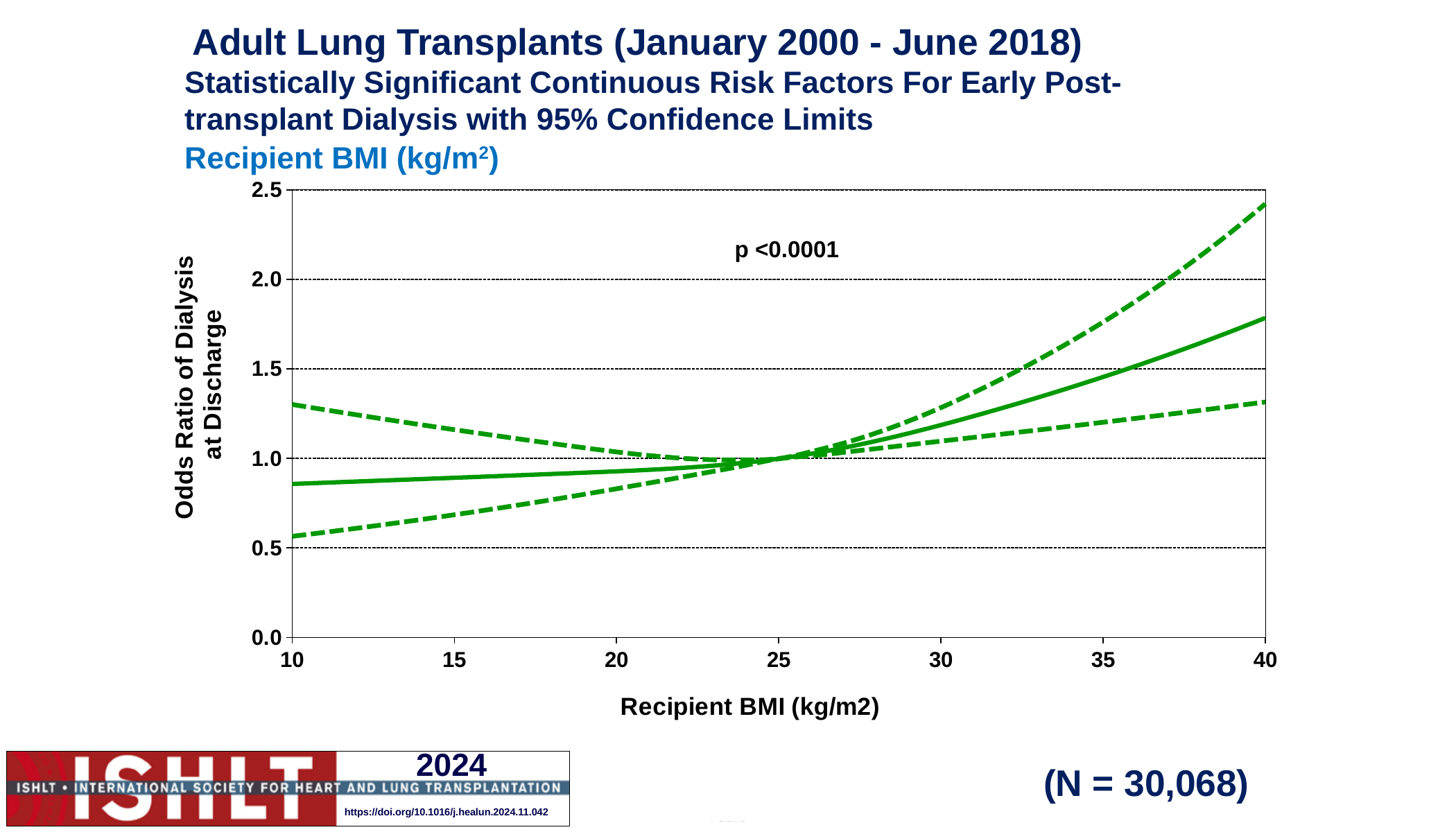
Is the upper dashed confidence limit at a recipient BMI of 40 greater or less than 2.0? greater Does the solid odds ratio line rise or fall as recipient BMI increases from 10 to 40? rise Is the upper dashed confidence limit at a recipient BMI of 10 greater or less than 1.0? greater How many tick labels are shown on the x axis? 7 Is the lower dashed confidence limit at a recipient BMI of 10 greater or less than 1.0? less What p-value is printed on the chart? p <0.0001 How many lines are plotted on the chart? 3 What is the label of the y axis? Odds Ratio of Dialysis at Discharge What kind of chart is shown on the slide? line chart